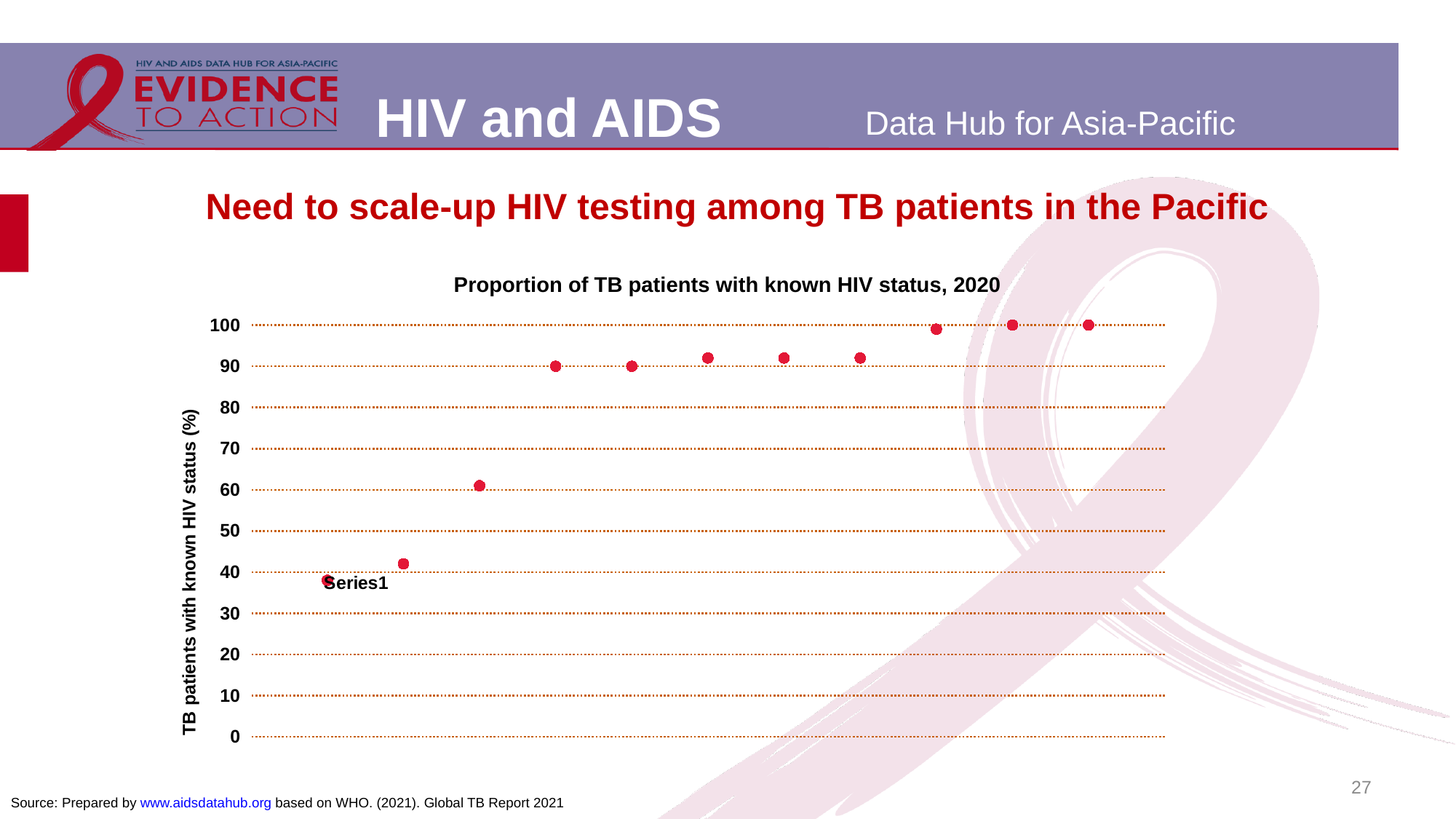
Do the plotted values rise or fall from left to right along the x axis? rise Is the value of the leftmost point greater or less than 50? less What is the title of the chart? Proportion of TB patients with known HIV status, 2020 How many data points are plotted on the chart? 11 Is the value of the rightmost point greater or less than 90? greater What is the highest value shown on the vertical axis? 100 What is the label of the vertical axis? TB patients with known HIV status (%) Which point has the lowest value, the leftmost or the rightmost? leftmost What kind of chart is shown on the slide? scatter (dot) chart Is the value of the second point from the left greater or less than 60? less